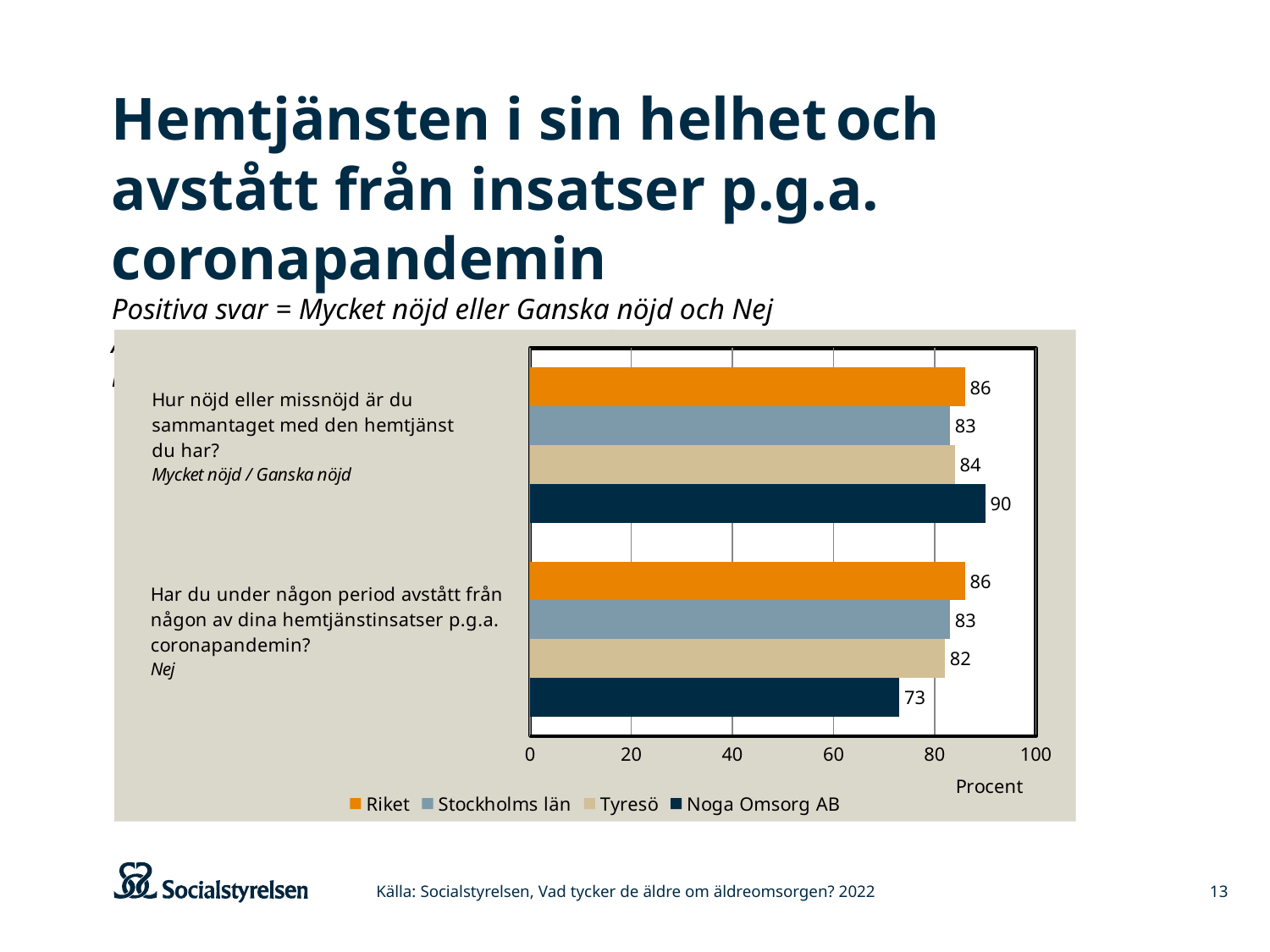
For the question about refraining from home care services due to the corona pandemic, which is larger: Stockholms län or Tyresö? Stockholms län What value does Tyresö have for the question 'Har du under någon period avstått från någon av dina hemtjänstinsatser p.g.a. coronapandemin?' 82 How many series does the legend list? 4 What is the difference between Riket and Noga Omsorg AB for the question about refraining from home care services due to the corona pandemic? 13 Which series has the highest value for the question 'Hur nöjd eller missnöjd är du sammantaget med den hemtjänst du har?' Noga Omsorg AB What value does Noga Omsorg AB have for the question 'Hur nöjd eller missnöjd är du sammantaget med den hemtjänst du har?' 90 What kind of chart is shown on the slide? Bar chart What is the label on the horizontal axis of the chart? Procent What is the difference between Noga Omsorg AB and Stockholms län for the question 'Hur nöjd eller missnöjd är du sammantaget med den hemtjänst du har?' 7 Which series has the lowest value for the question about refraining from home care services due to the corona pandemic? Noga Omsorg AB What value does Riket have for the question about being satisfied with the home care service overall? 86 Is the value for Noga Omsorg AB on the question about refraining from home care services due to the corona pandemic greater or less than 80? less